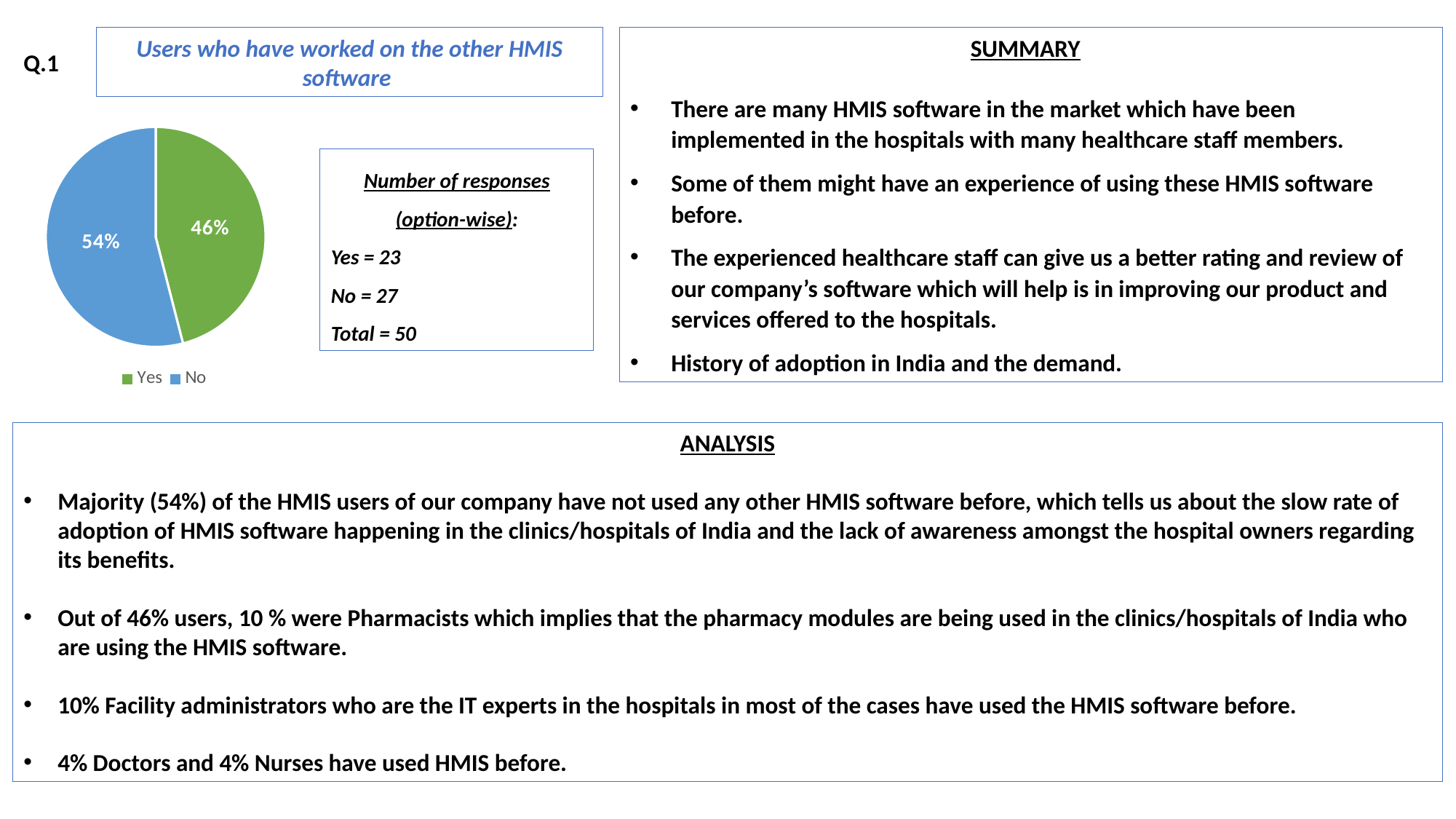
Which slice of the pie is the smallest? Yes What colour is the Yes slice in the pie chart? Green Which slice of the pie is the largest? No What share of the pie does the No slice represent? 54% How many entries does the legend list? 2 What share of the pie does the Yes slice represent? 46% What is the difference in percentage points between the No slice and the Yes slice? 8% What is the title of the pie chart? Users who have worked on the other HMIS software Which is larger, the Yes slice or the No slice? No What kind of chart is shown on the slide? Pie chart How many slices does the pie chart have? 2 Is the share for the No slice greater or less than 50%? greater